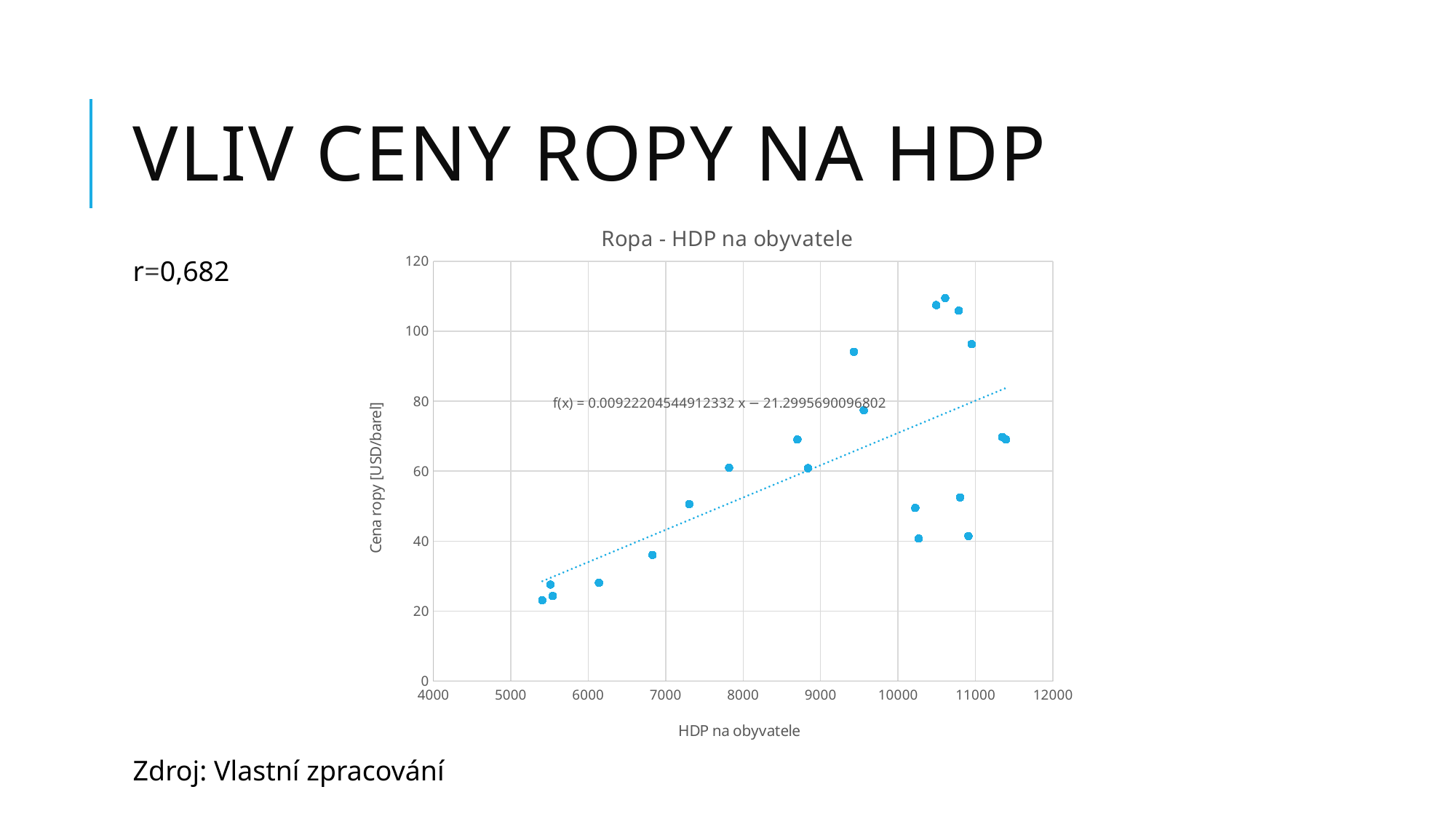
Is the oil price of the point near HDP na obyvatele 6800 greater or less than 40? less Is the oil price of the point near HDP na obyvatele 9400 greater or less than 80? greater What is the title of the chart? Ropa - HDP na obyvatele What is the label of the vertical axis of the chart? Cena ropy [USD/barel] Is the highest oil price plotted on the chart greater or less than 100? greater Do the plotted oil prices generally rise or fall as HDP na obyvatele increases along the x axis? rise What kind of chart is shown on the slide? scatter chart